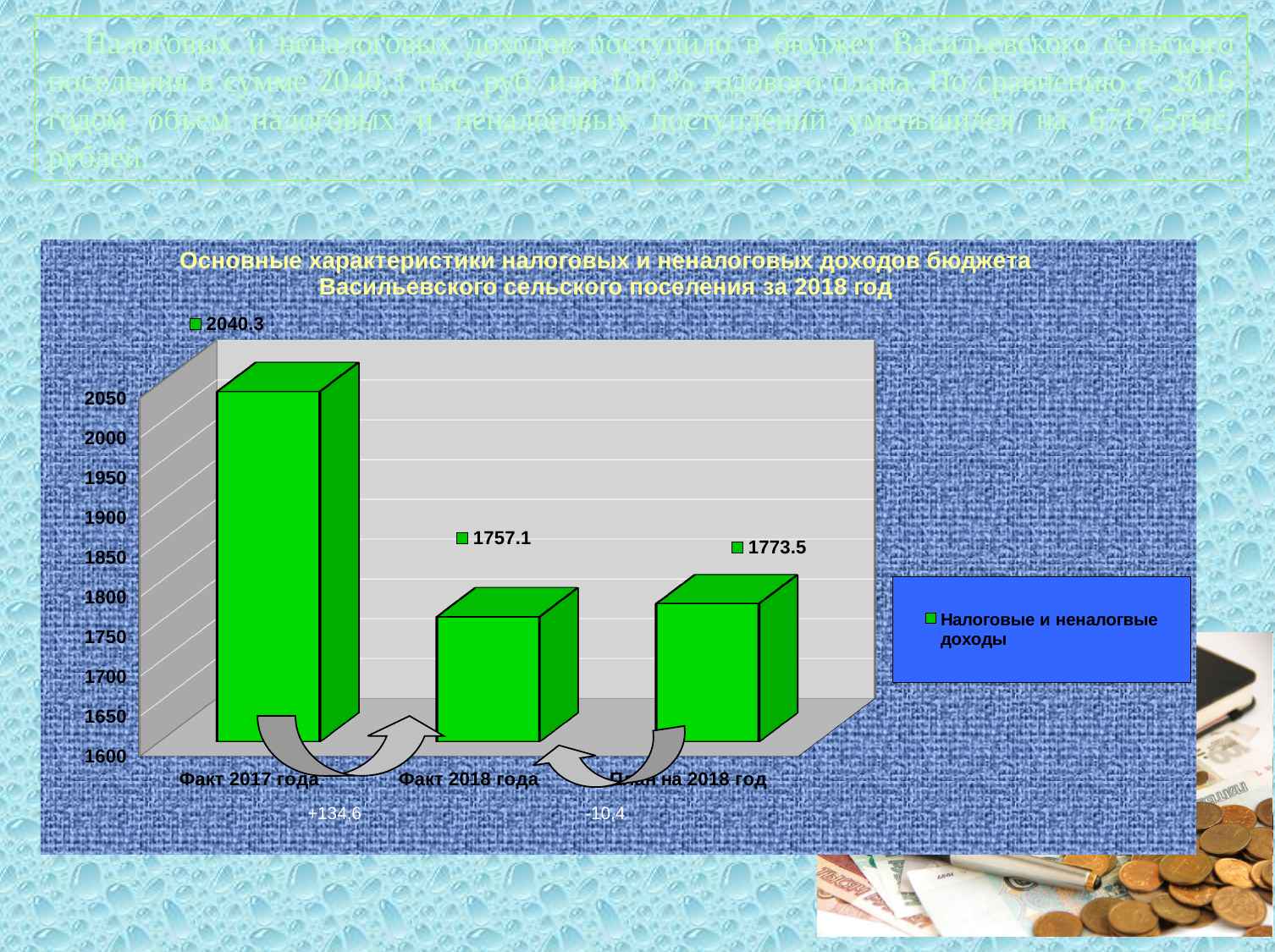
Which category has the highest value? Факт 2017 года What kind of chart is shown on the slide? bar chart What is the value for План на 2018 год? 1773.5 How many categories are shown on the x axis? 3 Is the value for Факт 2018 года greater or less than 1800? less Which is larger, the value for Факт 2017 года or the value for План на 2018 год? Факт 2017 года What is the value for Факт 2018 года? 1757.1 Which category has the lowest value? Факт 2018 года What is the difference between the values for План на 2018 год and Факт 2018 года? 16.4 What series name does the legend show? Налоговые и неналогвые доходы What is the difference between the values for Факт 2017 года and Факт 2018 года? 283.2 What is the value for Факт 2017 года? 2040.3